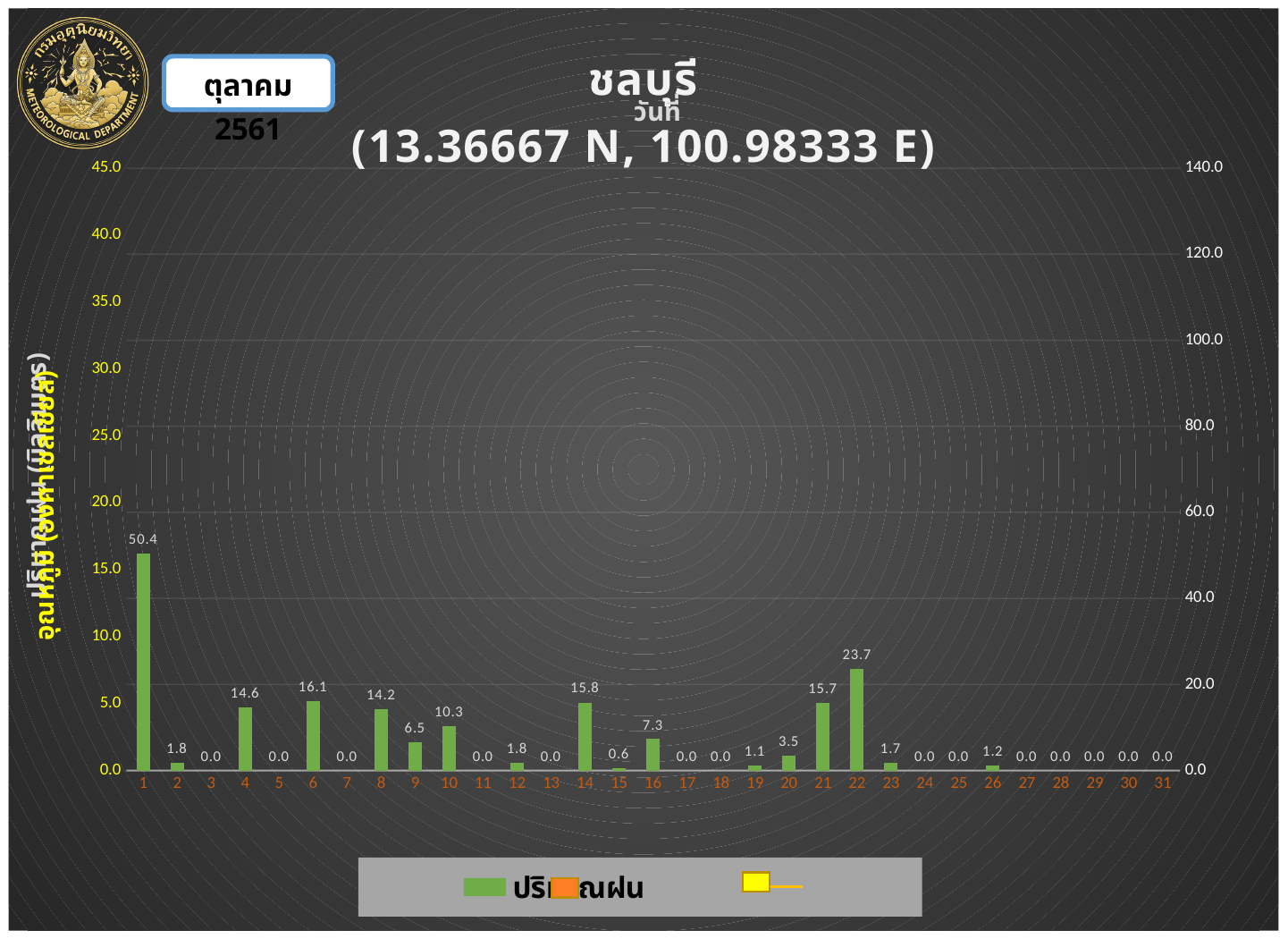
What is the value for day 14? 15.8 What is the value for day 22? 23.7 What is the value for day 1? 50.4 What is the value for day 9? 6.5 What is the difference between the values for day 22 and day 21? 8.0 Which is larger, the value for day 16 or the value for day 10? day 10 Which is larger, the value for day 6 or the value for day 8? day 6 How many days are shown on the x axis? 31 What is the difference between the values for day 1 and day 22? 26.7 Which day has the highest value? 1 What is the title of the chart? ชลบุรี (13.36667 N, 100.98333 E) What kind of chart is shown on the slide? bar chart